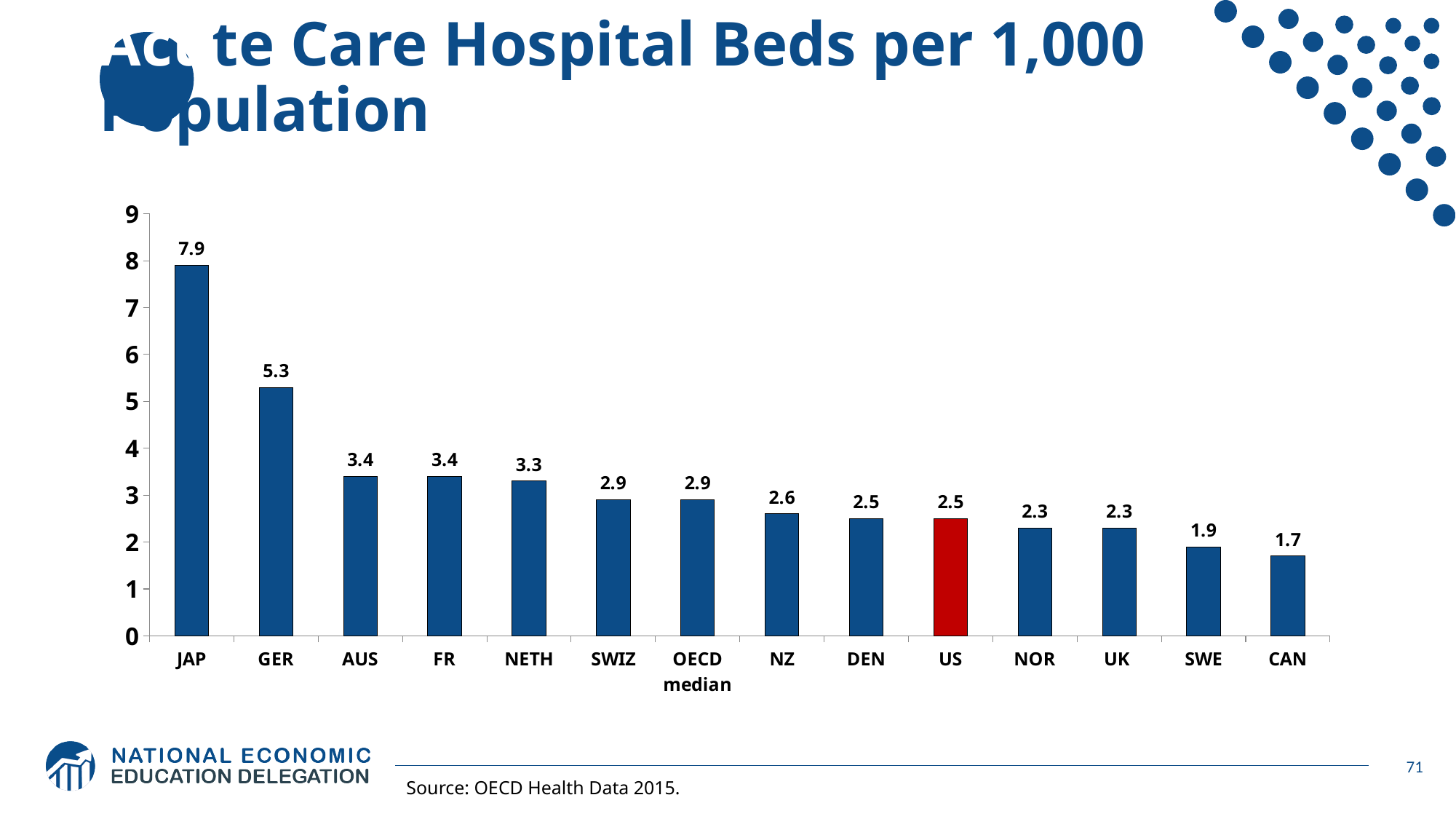
What kind of chart is shown on the slide? bar chart Is the value for GER greater or less than 5? greater What is the value for the US? 2.5 Which country has the lowest number of acute care hospital beds per 1,000 population? CAN What is the difference between the values for JAP and GER? 2.6 What is the value for JAP? 7.9 Which country has the highest number of acute care hospital beds per 1,000 population? JAP Which has a larger value, NETH or SWIZ? NETH Which bar is coloured red instead of blue? US How many bars are shown in the chart? 14 What is the difference between the values for the OECD median and the US? 0.4 What is the value for the OECD median? 2.9